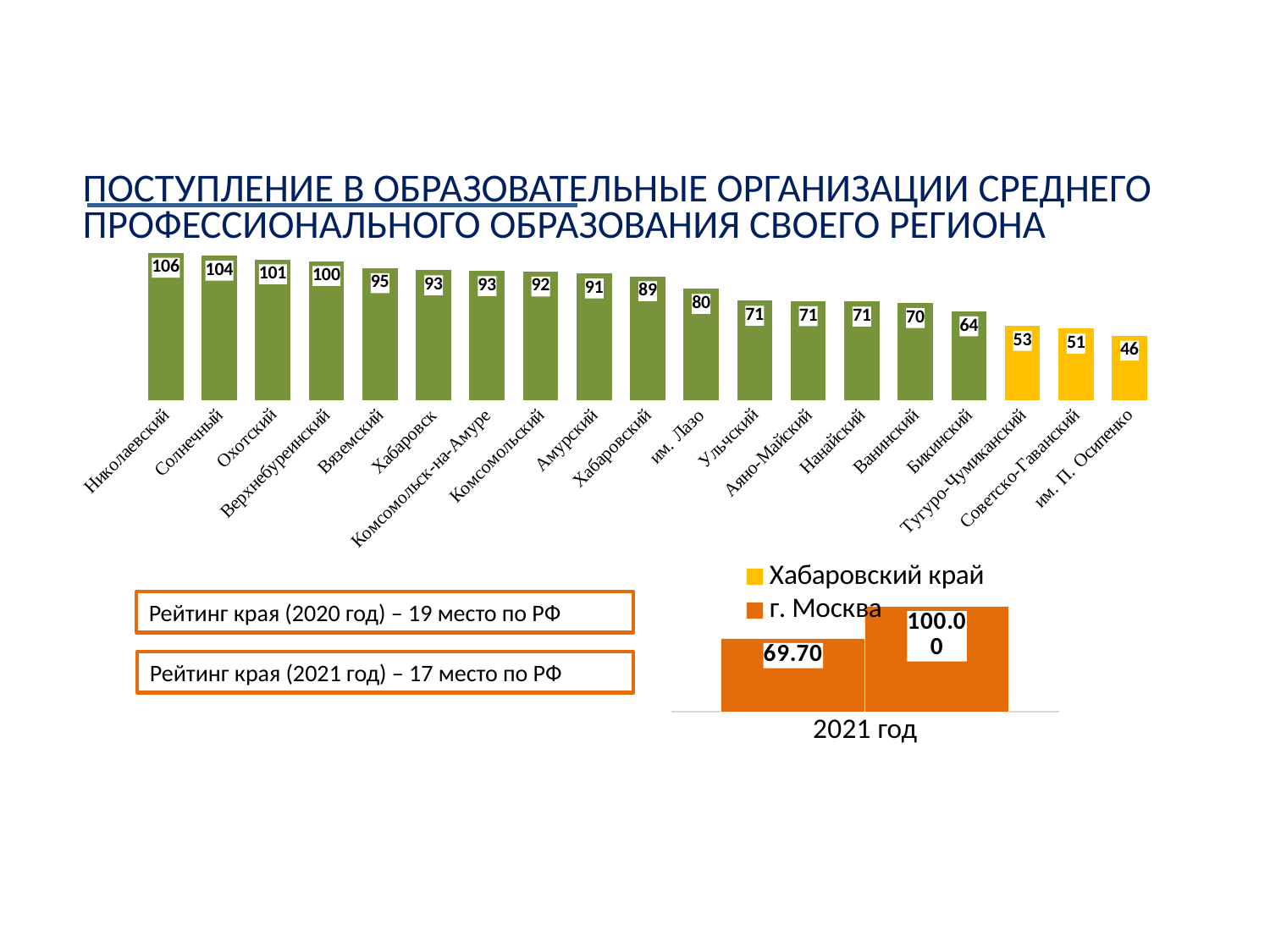
In the top chart, what is the value for им. Лазо? 80 How many categories are shown in the top chart? 19 In the top chart, which category has the lowest value? им. П. Осипенко How many series does the legend of the bottom chart list? 2 What kind of chart is the top chart? bar chart In the top chart, which category has the highest value? Николаевский In the top chart, what is the value for Бикинский? 64 In the bottom chart, what is the difference between the two bars for 2021 год (100.00 and 69.70)? 30.30 Do the values in the top chart rise or fall from left to right? fall In the top chart, which is larger: the value for Вяземский or the value for Ванинский? Вяземский In the top chart, what is the difference between the values for Солнечный and Советско-Гаванский? 53 In the top chart, what is the value for Николаевский? 106